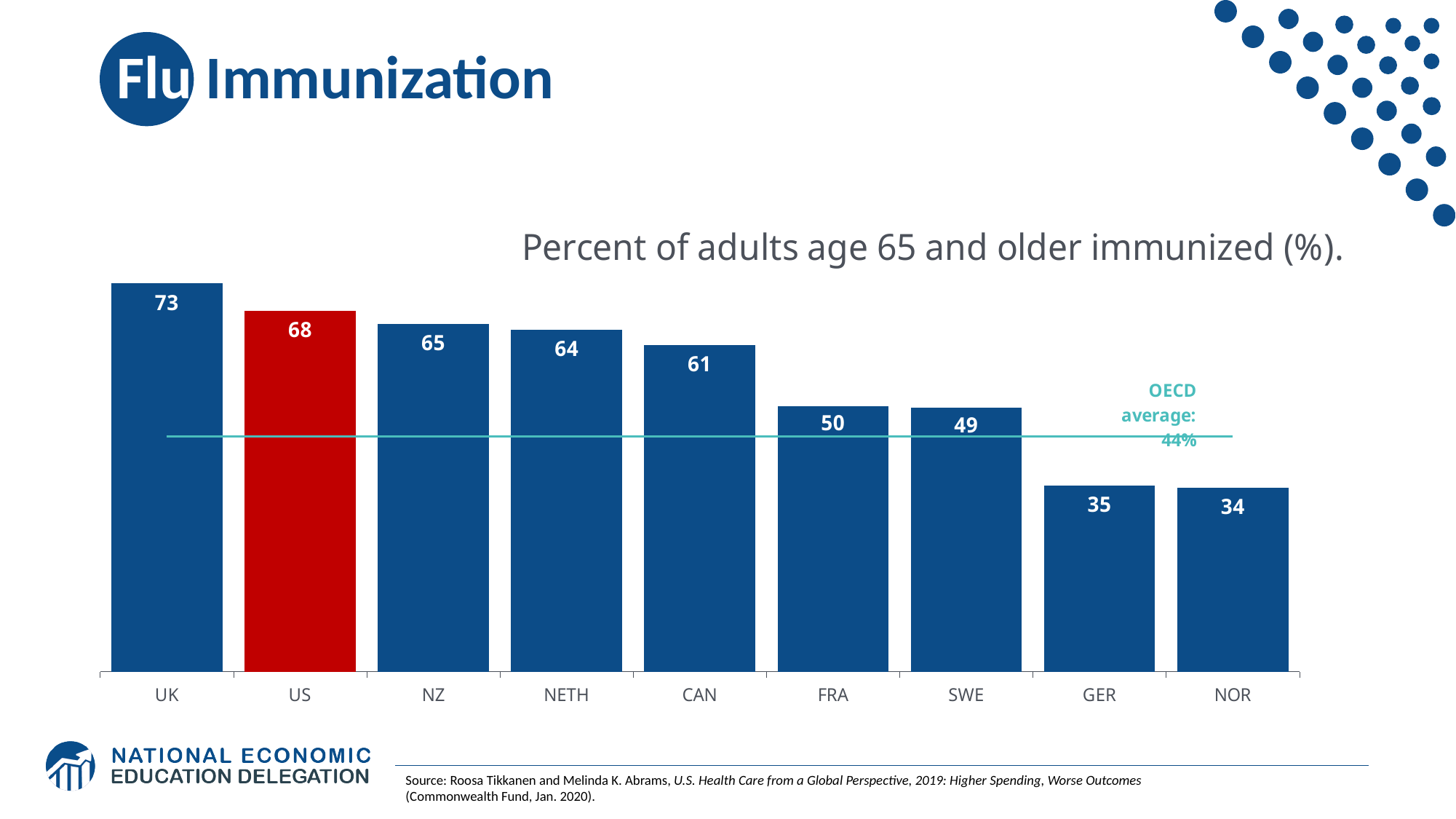
What is the value for NOR? 34 Do the values rise or fall from left to right across the countries? Fall What is the difference between the values for FRA and GER? 15 What is the difference between the values for the UK and the US? 5 What kind of chart is shown on the slide? Bar chart How many countries are shown in the chart? 9 Which country has the highest value? UK What is the value for the US? 68 Which country has the lowest value? NOR Which is larger, the value for NZ or the value for SWE? NZ What OECD average is marked by the horizontal line on the chart? 44% What is the value for CAN? 61